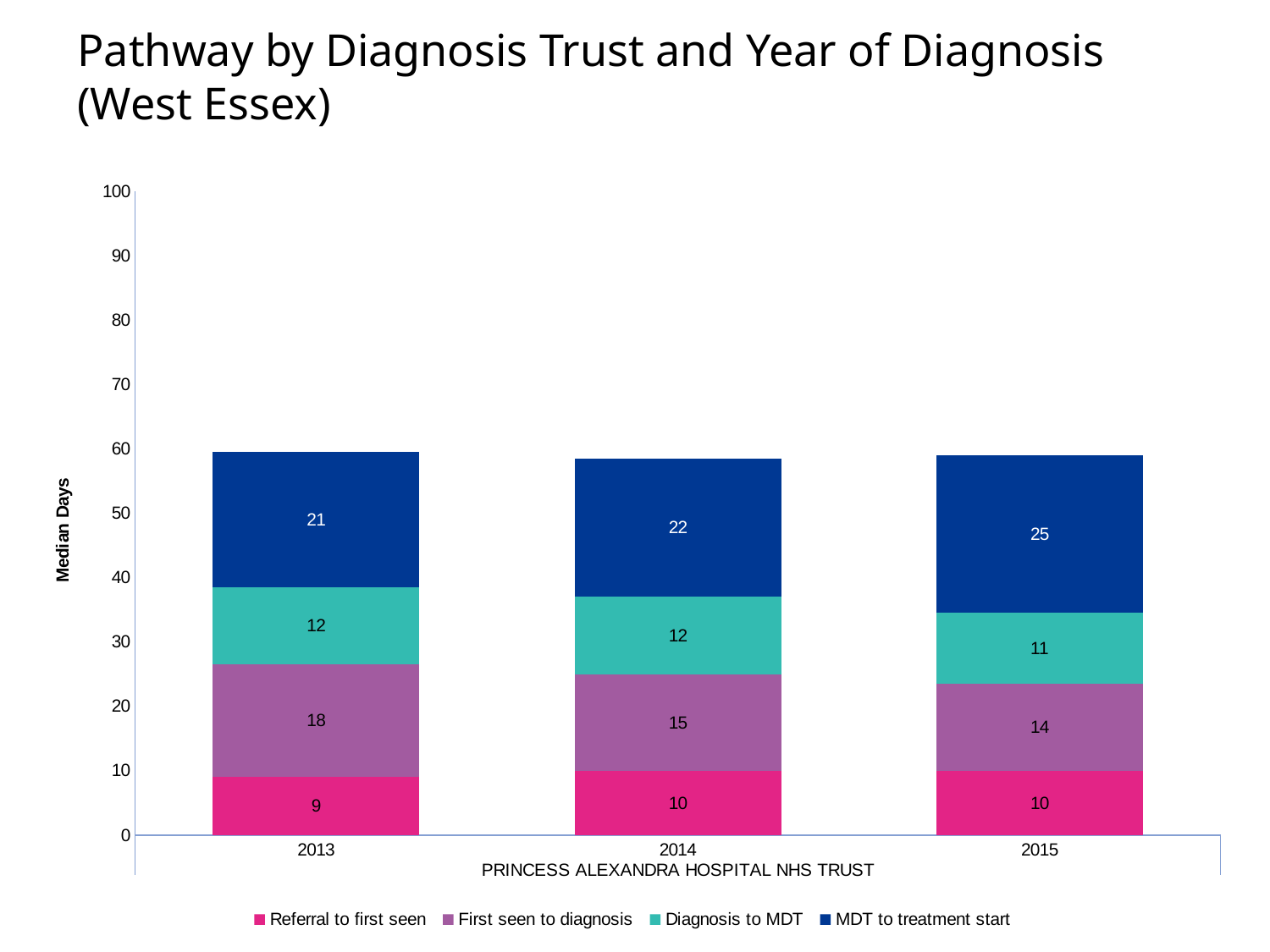
What is the difference between the MDT to treatment start values for 2015 and 2013? 4 What is the median days value for Referral to first seen in 2014? 10 How many years are shown on the x axis? 3 What kind of chart is shown on the slide? Stacked bar chart In which year is the First seen to diagnosis value lowest? 2015 In which year is the MDT to treatment start value highest? 2015 Which is larger: First seen to diagnosis in 2013 or in 2014? 2013 What is the total of the stacked bar for 2014? 59 What is the median days value for First seen to diagnosis in 2013? 18 What is the median days value for MDT to treatment start in 2015? 25 How many series does the legend list? 4 What is the median days value for Diagnosis to MDT in 2015? 11